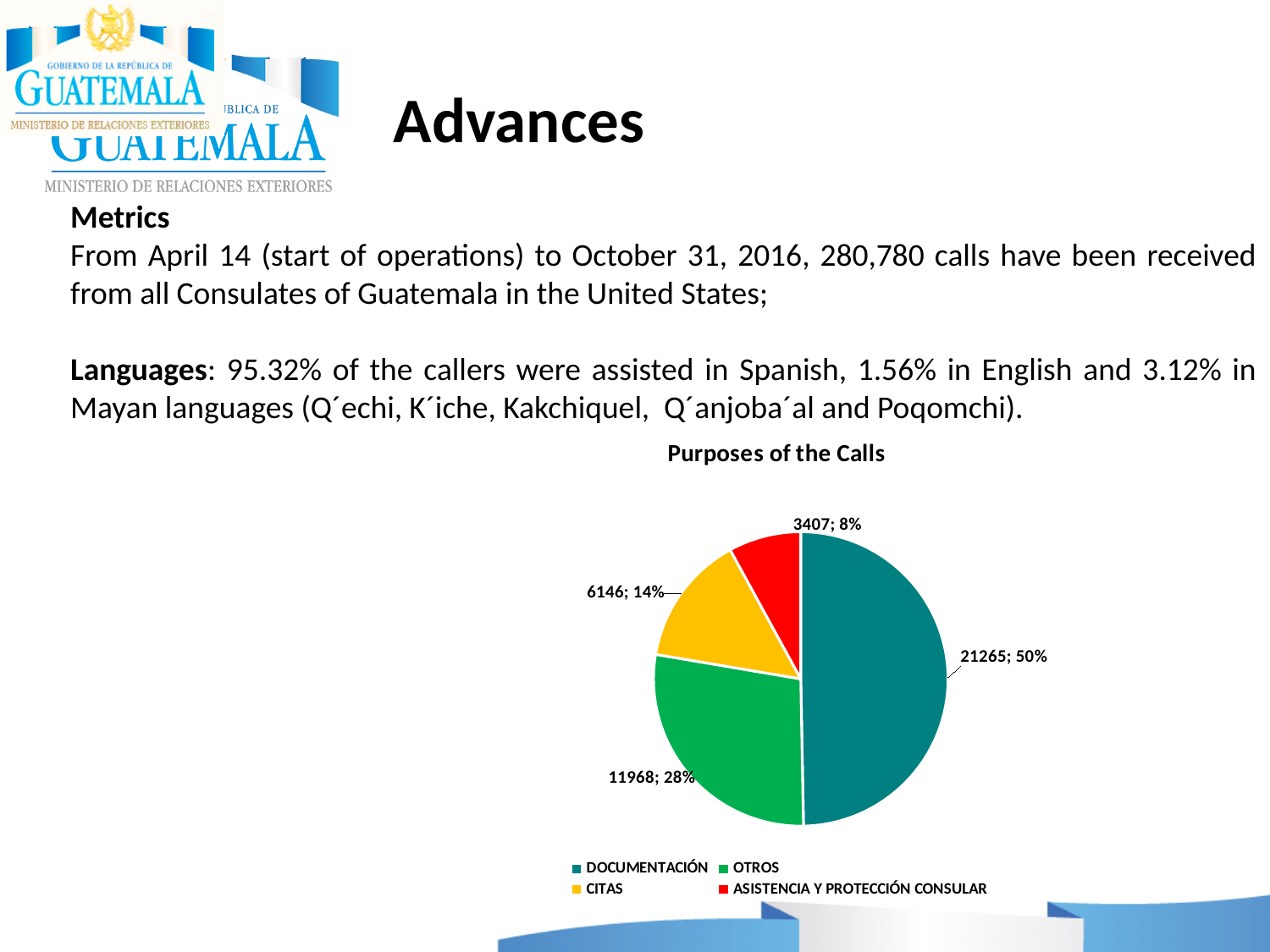
What is the title of the chart on the slide? Purposes of the Calls Which category has the largest slice in the "Purposes of the Calls" chart? DOCUMENTACIÓN What type of chart is shown under the title "Purposes of the Calls"? Pie chart What is the value shown for CITAS in the "Purposes of the Calls" chart? 6146 How many slices does the "Purposes of the Calls" pie chart have? 4 How many entries does the legend of the "Purposes of the Calls" chart list? 4 What is the value shown for DOCUMENTACIÓN in the "Purposes of the Calls" chart? 21265 What share of the pie does CITAS represent in the "Purposes of the Calls" chart? 14% What is the difference between the values for DOCUMENTACIÓN and OTROS in the "Purposes of the Calls" chart? 9297 What is the value shown for OTROS in the "Purposes of the Calls" chart? 11968 Which category has the smallest slice in the "Purposes of the Calls" chart? ASISTENCIA Y PROTECCIÓN CONSULAR What is the value shown for ASISTENCIA Y PROTECCIÓN CONSULAR in the "Purposes of the Calls" chart? 3407